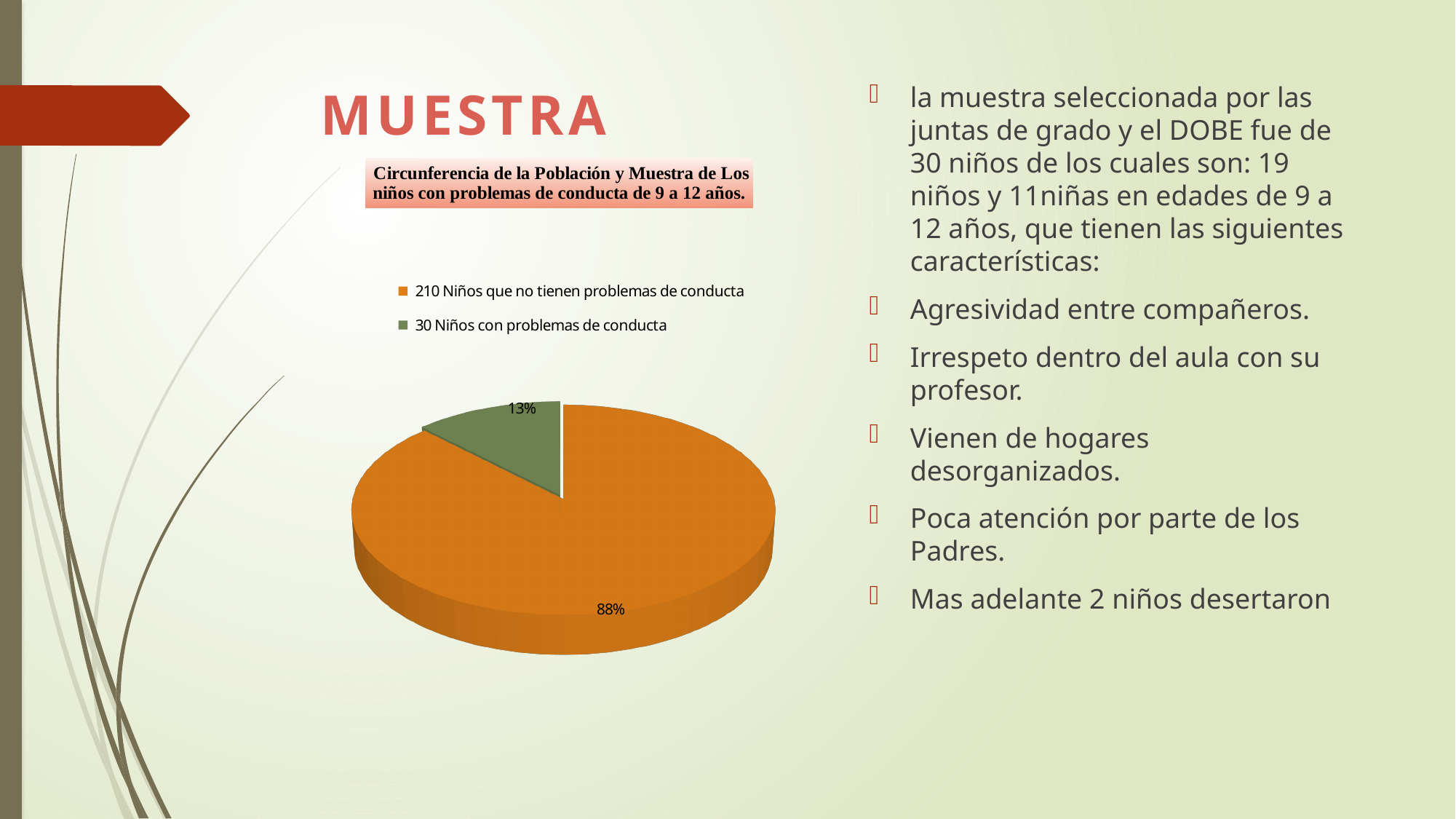
What is the title of the chart? Circunferencia de la Población y Muestra de Los niños con problemas de conducta de 9 a 12 años. What percentage of the pie is labelled for "30 Niños con problemas de conducta"? 13% How many entries does the legend list? 2 Which slice is larger: "210 Niños que no tienen problemas de conducta" or "30 Niños con problemas de conducta"? 210 Niños que no tienen problemas de conducta How many slices does the pie chart have? 2 What kind of chart is shown on the slide? Pie chart What percentage of the pie is labelled for "210 Niños que no tienen problemas de conducta"? 88% Which category has the largest slice of the pie? 210 Niños que no tienen problemas de conducta What is the difference in percentage points between the 88% slice and the 13% slice? 75 What colour is the slice for "30 Niños con problemas de conducta"? Green What share of the pie does the green slice represent? 13% Which category has the smallest slice of the pie? 30 Niños con problemas de conducta